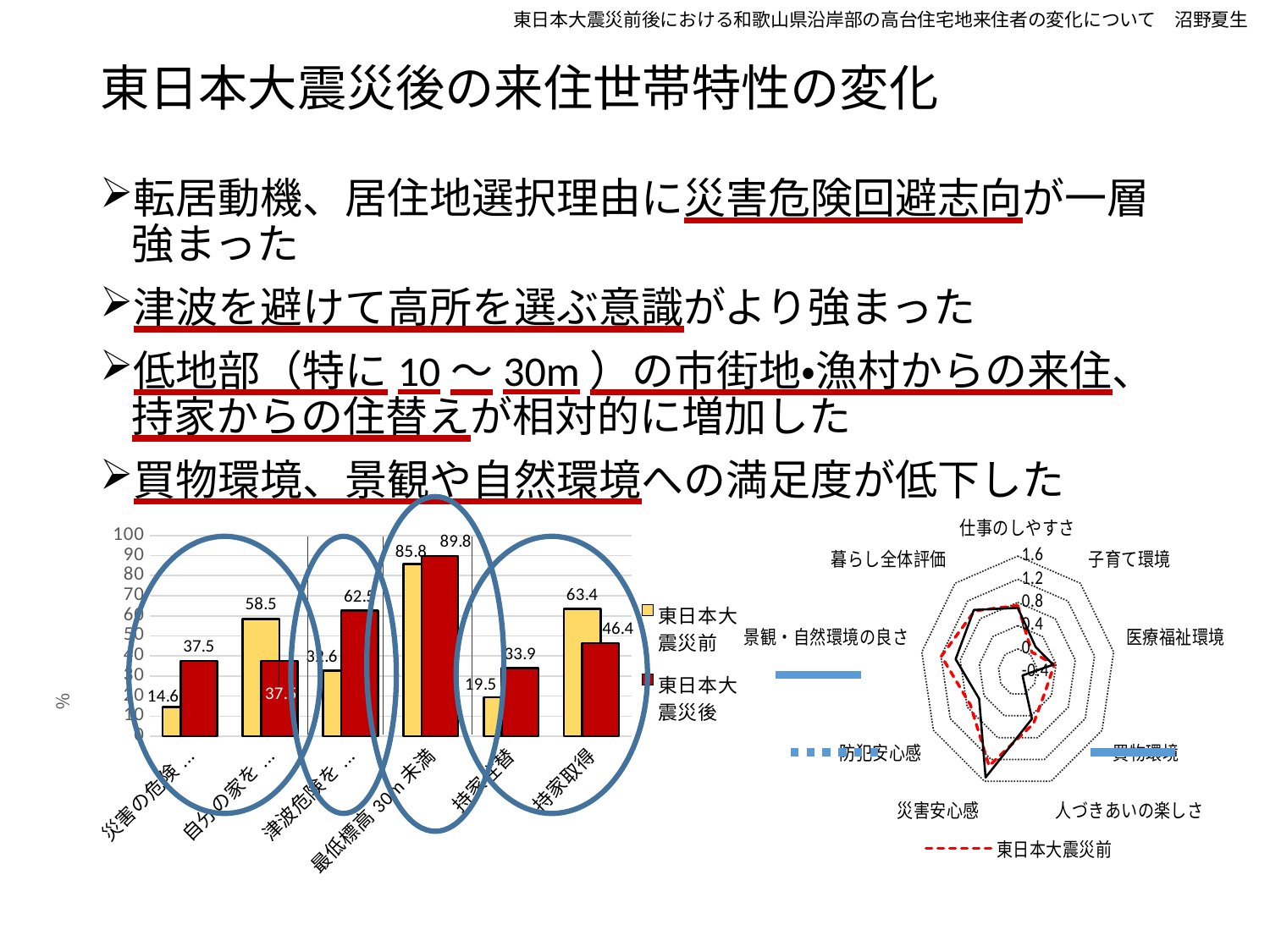
In the bar chart on the left, how many categories are shown on the x axis? 6 What kind of chart is the chart on the left of the slide? bar chart What kind of chart is the chart on the right of the slide? radar chart In the bar chart on the left, which category has the highest 東日本大震災後 value? 最低標高30m未満 In the bar chart on the left, what is the value for 最低標高30m未満 in the 東日本大震災前 series? 85.8 In the bar chart on the left, which series has the larger value for 最低標高30m未満, 東日本大震災前 or 東日本大震災後? 東日本大震災後 In the bar chart on the left, what is the value for 最低標高30m未満 in the 東日本大震災後 series? 89.8 In the bar chart on the left, what is the value for 持家取得 in the 東日本大震災後 series? 46.4 In the bar chart on the left, how many series does the legend list? 2 In the bar chart on the left, what is the difference between the 東日本大震災前 and 東日本大震災後 values for 持家取得? 17.0 In the bar chart on the left, what is the value for 持家取得 in the 東日本大震災前 series? 63.4 In the radar chart on the right, how many axes (categories) are shown? 9